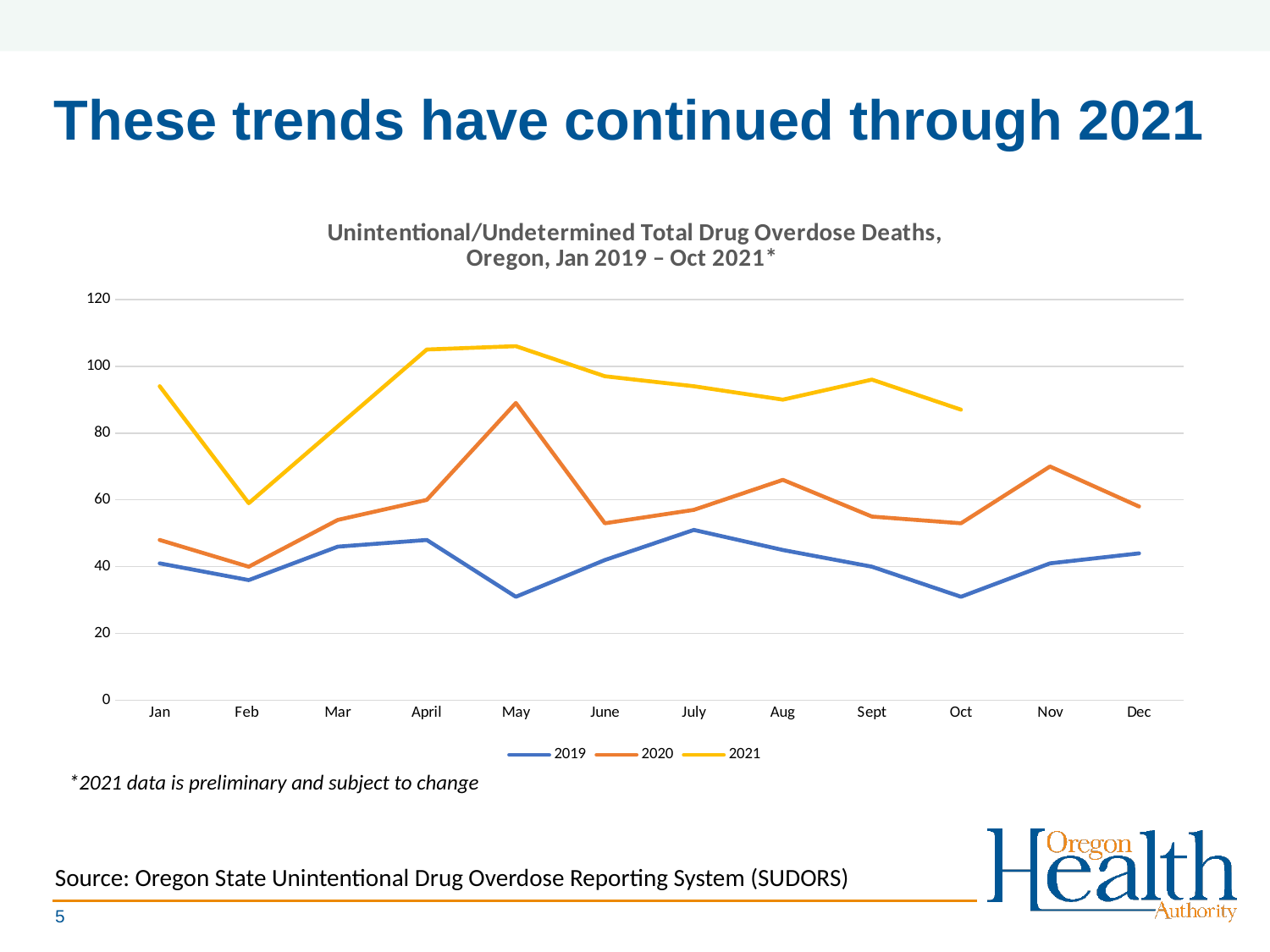
What kind of chart is shown on the slide? line chart How many months are shown on the x axis? 12 Is the value for 2020 in May greater or less than 80? greater Is the value for 2019 in May greater or less than 40? less In May, which series has the larger value, 2019 or 2020? 2020 Through which month does the 2021 line extend? Oct Does the 2021 series rise or fall from May to Aug? fall Is the value for 2020 in Nov greater or less than 60? greater How many series does the legend list? 3 In which month does the 2021 series reach its lowest value? Feb In which month does the 2020 series reach its highest value? May